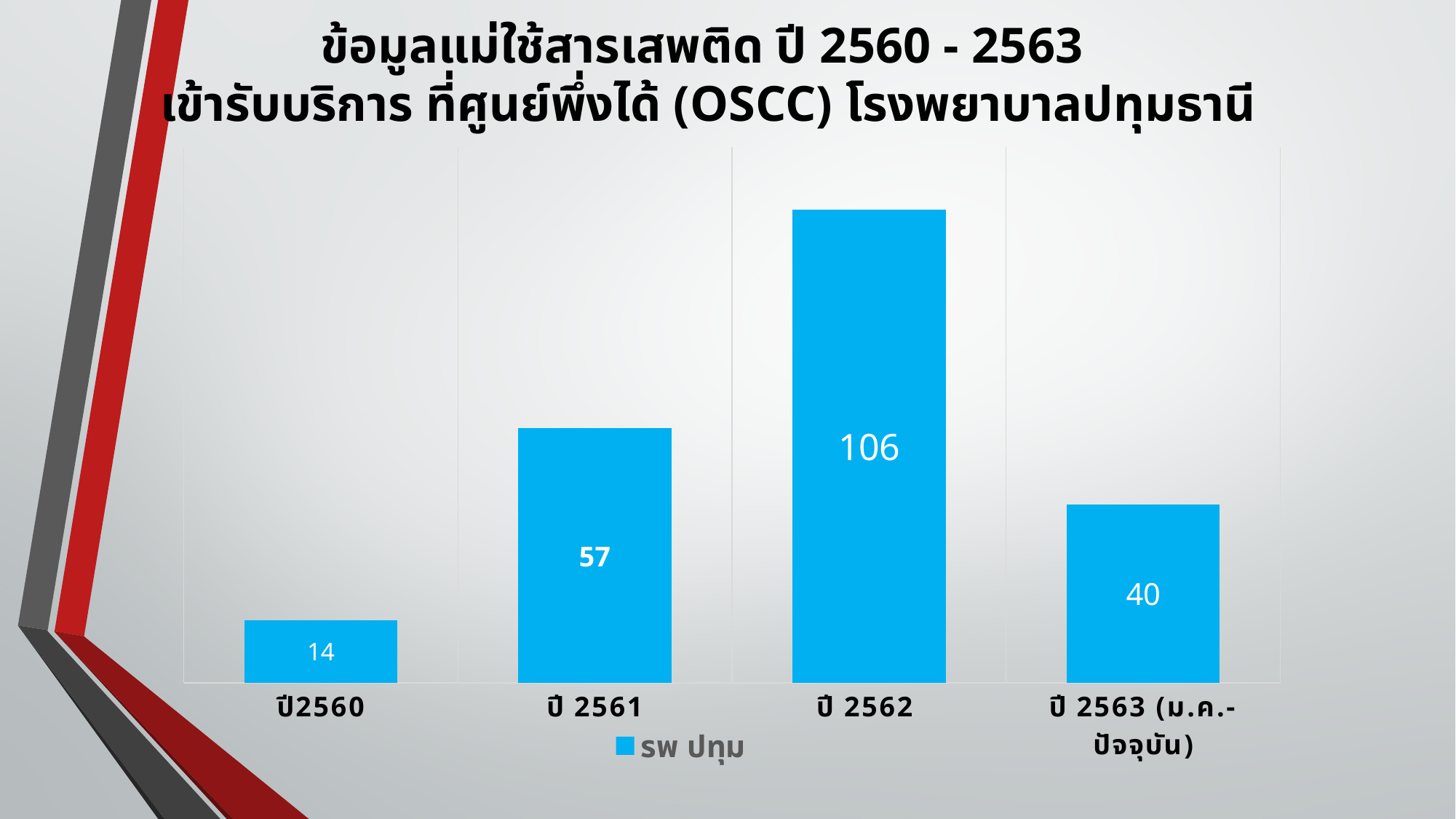
What is the difference between the values for ปี 2562 and ปี 2561? 49 What is the value for ปี 2561? 57 What is the difference between the values for ปี 2561 and ปี 2563 (ม.ค.-ปัจจุบัน)? 17 What series name does the legend show? รพ ปทุม How many categories are shown on the x axis? 4 Which year has the highest value? ปี 2562 Which year has the lowest value? ปี2560 What kind of chart is shown on the slide? bar chart What is the value for ปี 2562? 106 What is the value for ปี2560? 14 Which is larger, the value for ปี 2561 or the value for ปี 2563 (ม.ค.-ปัจจุบัน)? ปี 2561 What is the value for ปี 2563 (ม.ค.-ปัจจุบัน)? 40